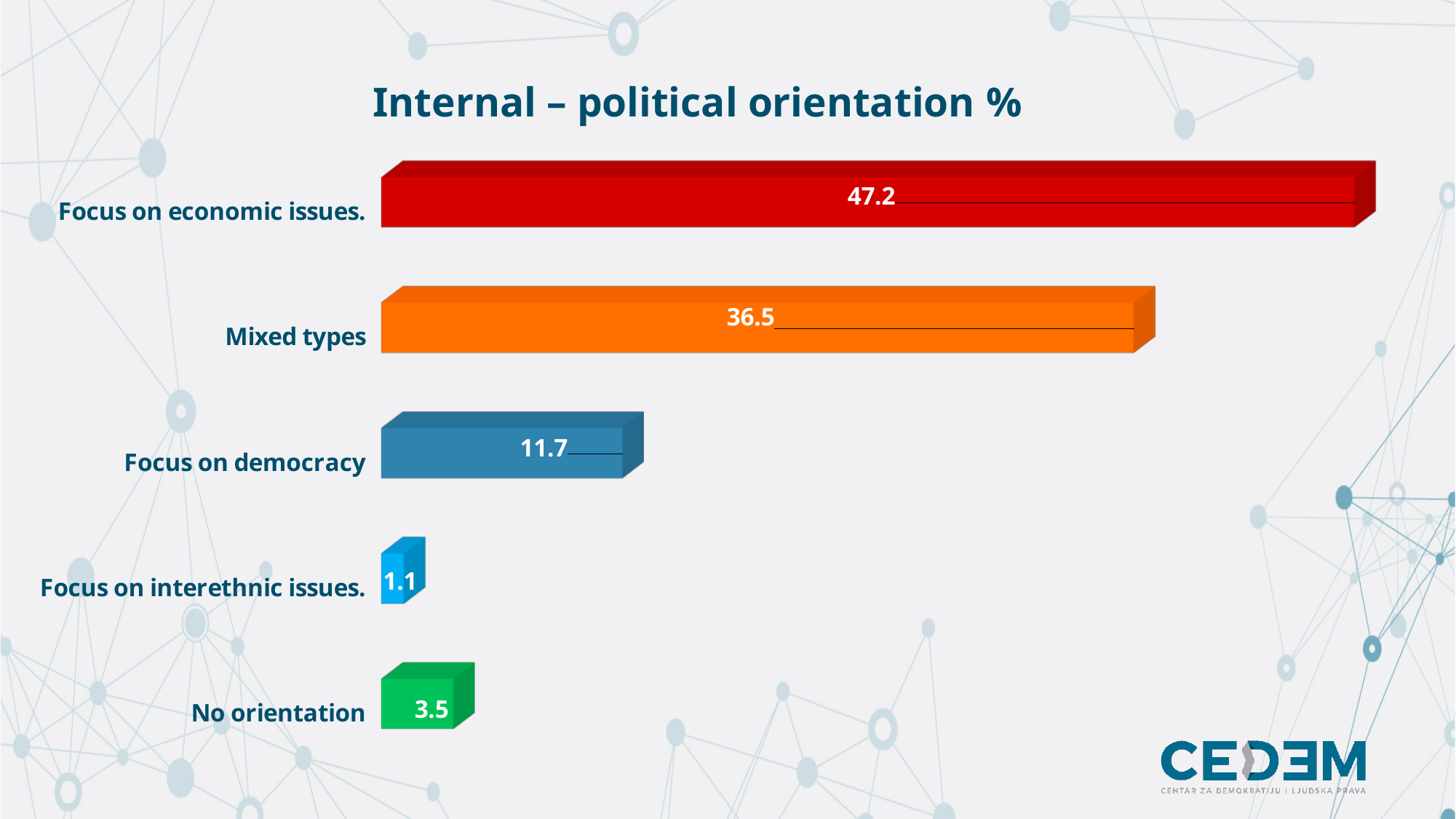
What is the value for Focus on interethnic issues? 1.1 What is the difference between Focus on economic issues and Mixed types? 10.7 What is the difference between No orientation and Focus on interethnic issues? 2.4 Which category has the lowest value? Focus on interethnic issues What is the value for Focus on economic issues? 47.2 What kind of chart is shown on the slide? Bar chart What is the value for No orientation? 3.5 What is the value for Focus on democracy? 11.7 Which is larger, Focus on democracy or No orientation? Focus on democracy Which category has the highest value? Focus on economic issues How many categories are shown in the chart? 5 What is the value for Mixed types? 36.5